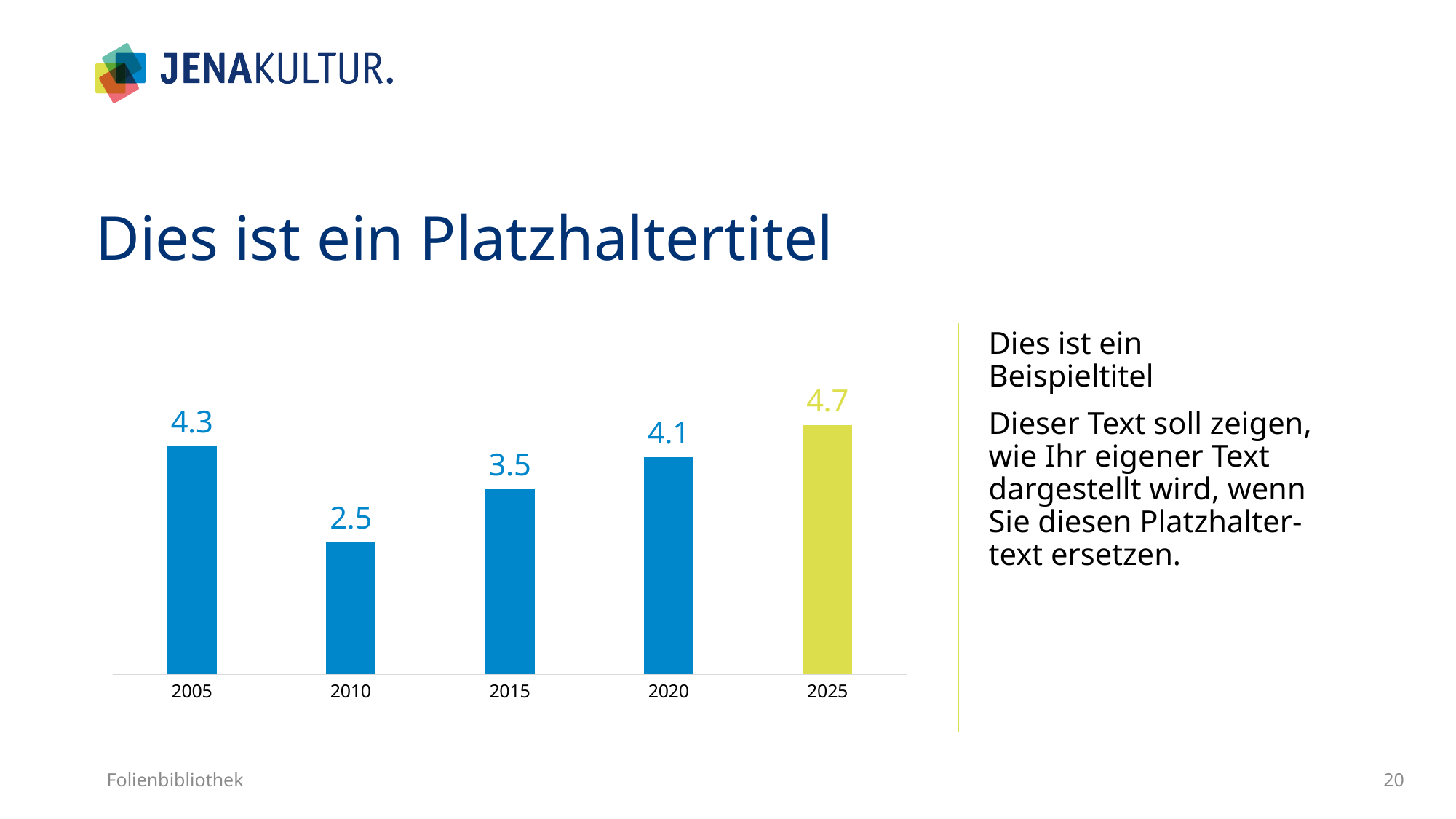
What is the difference between the values for 2025 and 2010? 2.2 What is the value for 2015? 3.5 Which year has the highest value? 2025 What is the value for 2020? 4.1 What is the value for 2025? 4.7 Which is larger, the value for 2005 or the value for 2020? 2005 What is the value for 2010? 2.5 Which bar is coloured differently from the others? 2025 What kind of chart is shown on the slide? Bar chart Which year has the lowest value? 2010 How many bars are shown in the chart? 5 What is the value for 2005? 4.3